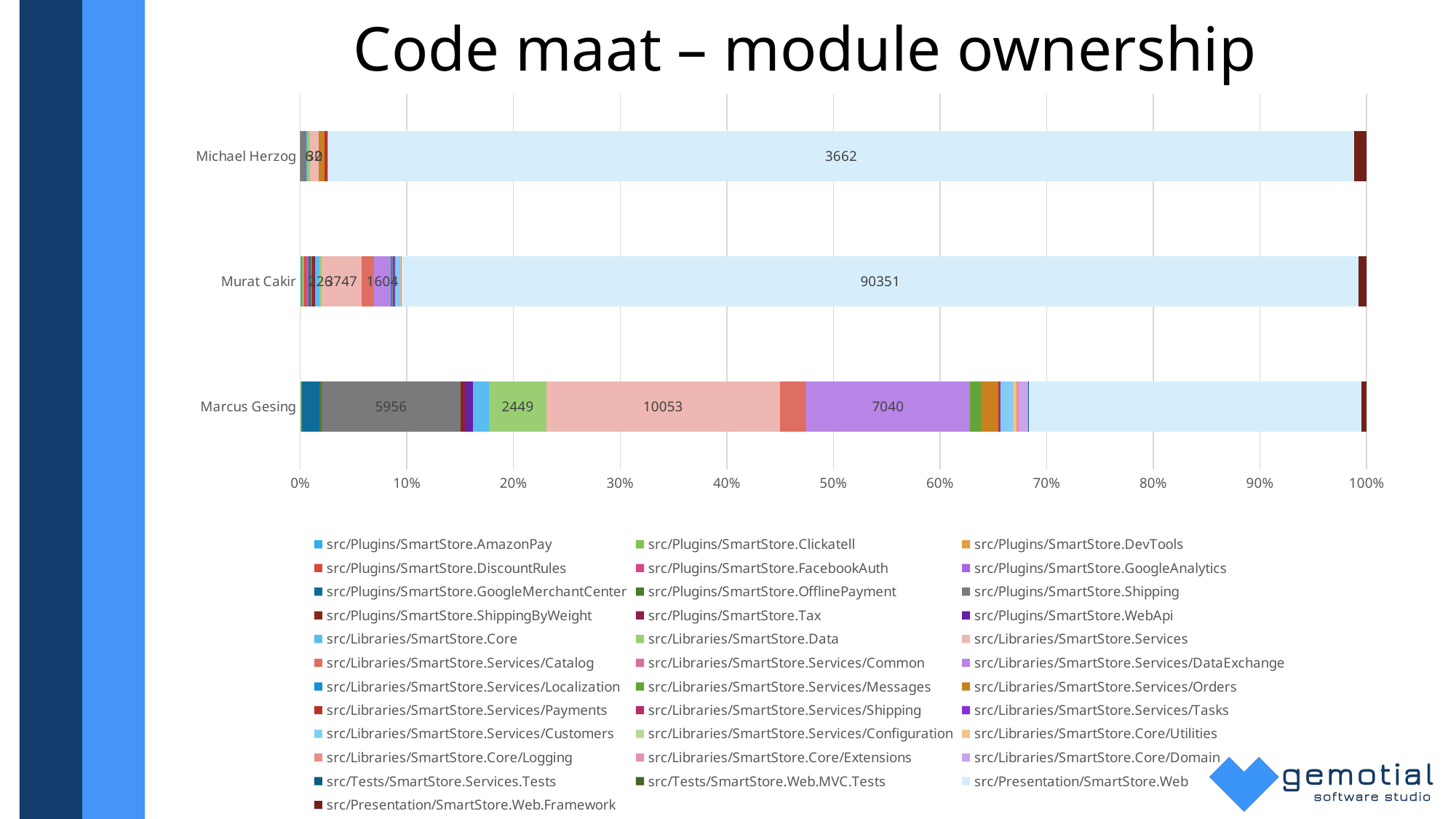
Is the share of Michael Herzog's bar taken by src/Presentation/SmartStore.Web greater or less than 90%? greater What is the title of the chart slide? Code maat – module ownership What is the difference between Marcus Gesing's src/Libraries/SmartStore.Services value (10053) and his src/Libraries/SmartStore.Services/DataExchange value (7040)? 3013 What is the value labelled on Michael Herzog's src/Presentation/SmartStore.Web segment? 3662 What is the value labelled on Marcus Gesing's src/Plugins/SmartStore.Shipping segment? 5956 How many series does the chart legend list? 34 What kind of chart is shown on the slide? Stacked bar chart How many people (categories) are shown on the y axis of the chart? 3 For Marcus Gesing, which is larger: the src/Libraries/SmartStore.Services segment or the src/Libraries/SmartStore.Services/DataExchange segment? src/Libraries/SmartStore.Services What is the value labelled on Marcus Gesing's src/Libraries/SmartStore.Services segment? 10053 What is the value labelled on Murat Cakir's src/Presentation/SmartStore.Web segment? 90351